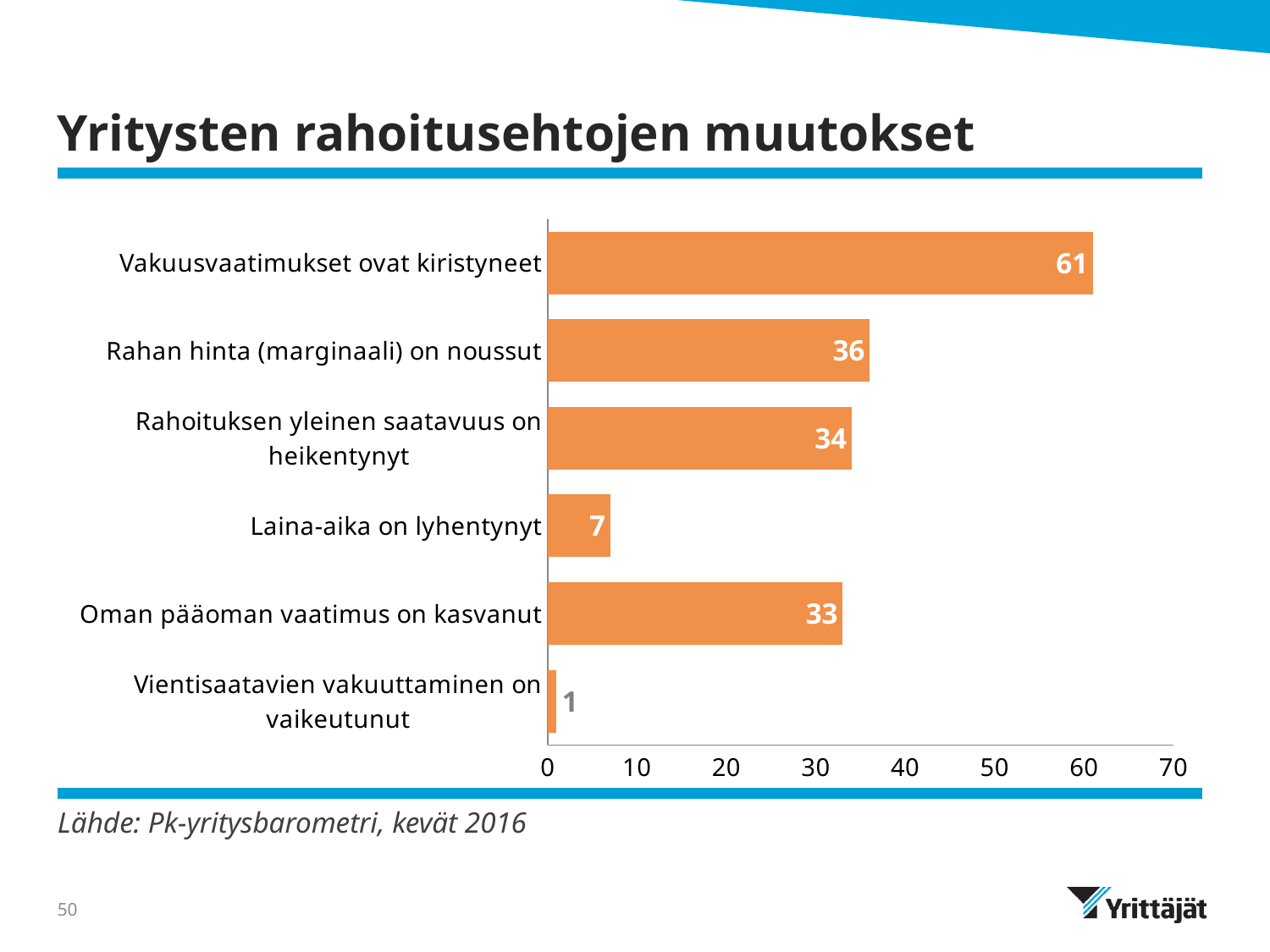
What is the difference between the values for "Rahoituksen yleinen saatavuus on heikentynyt" and "Oman pääoman vaatimus on kasvanut"? 1 What is the value for "Vientisaatavien vakuuttaminen on vaikeutunut"? 1 What is the value for "Laina-aika on lyhentynyt"? 7 What is the difference between the values for "Vakuusvaatimukset ovat kiristyneet" and "Rahan hinta (marginaali) on noussut"? 25 What is the title of the chart on the slide? Yritysten rahoitusehtojen muutokset How many categories are shown in the chart? 6 Which category has the lowest value? Vientisaatavien vakuuttaminen on vaikeutunut Which is larger: the value for "Rahan hinta (marginaali) on noussut" or the value for "Laina-aika on lyhentynyt"? Rahan hinta (marginaali) on noussut What kind of chart is shown on the slide? Bar chart Which category has the highest value? Vakuusvaatimukset ovat kiristyneet What is the value for "Rahan hinta (marginaali) on noussut"? 36 What is the value for "Vakuusvaatimukset ovat kiristyneet"? 61